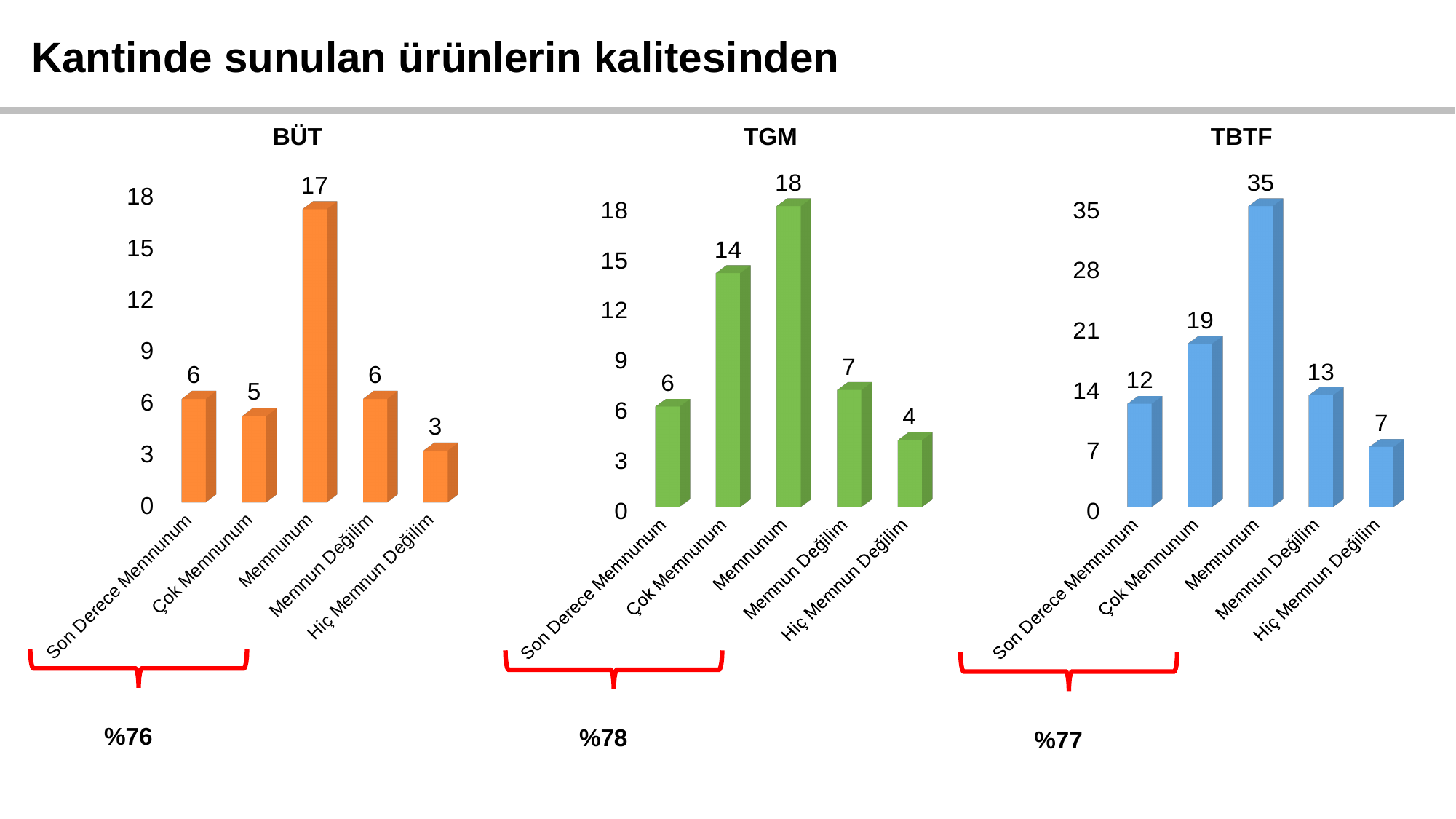
In the BÜT chart, what is the value for Memnunum? 17 In the TBTF chart, what is the value for Hiç Memnun Değilim? 7 In the TBTF chart, what is the difference between Çok Memnunum and Son Derece Memnunum? 7 What kind of chart is the TGM chart? bar chart In the TGM chart, what is the value for Çok Memnunum? 14 In the BÜT chart, which category has the lowest value? Hiç Memnun Değilim In the TGM chart, is the value for Memnunum greater or less than 15? greater How many categories does the TBTF chart show? 5 What colour are the bars in the BÜT chart? orange In the TGM chart, what is the difference between Memnunum and Hiç Memnun Değilim? 14 In the TBTF chart, which category has the highest value? Memnunum In the BÜT chart, which is larger: Çok Memnunum or Memnun Değilim? Memnun Değilim